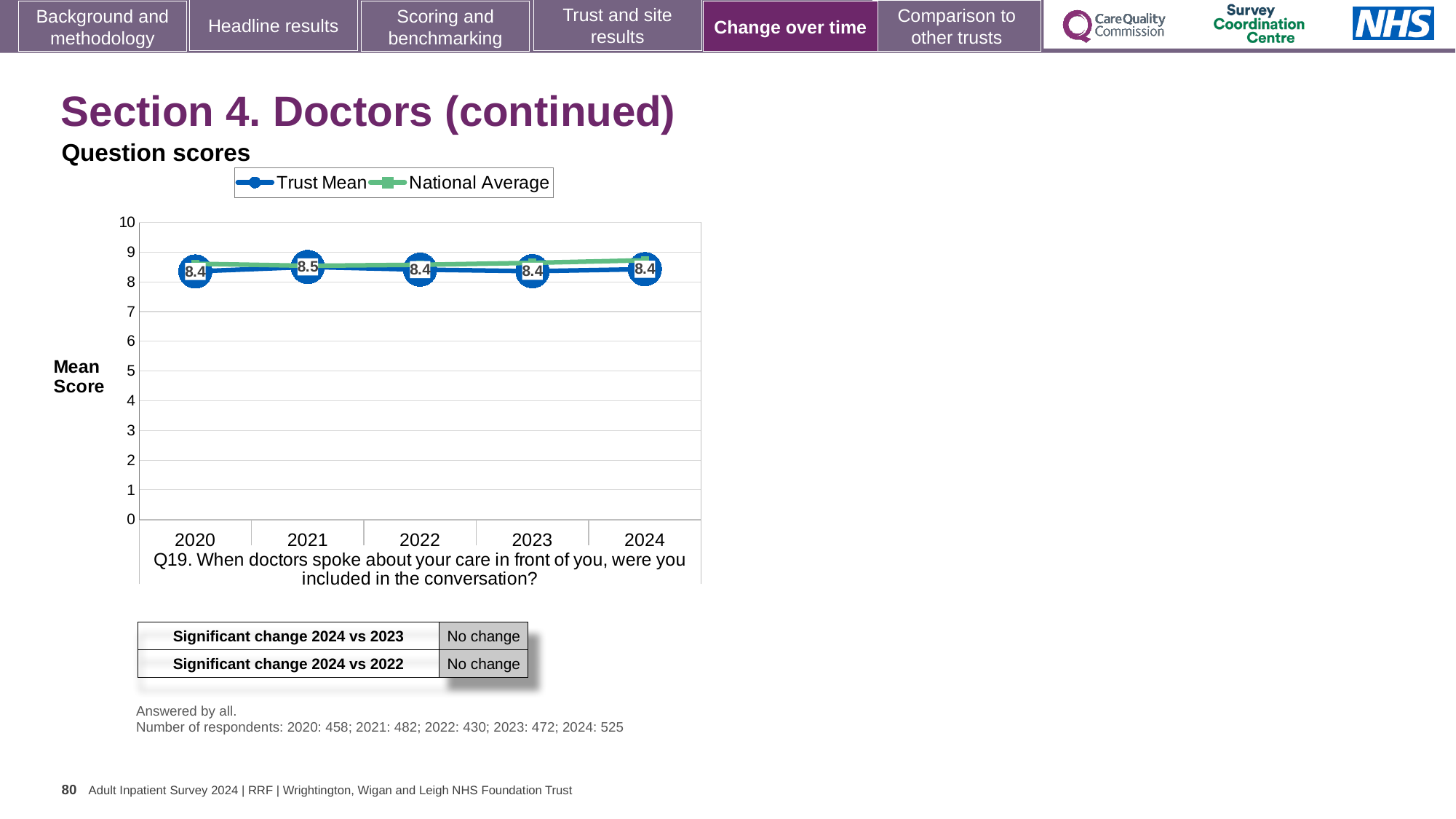
What kind of chart is shown on the slide? Line chart In which year is the Trust Mean score highest? 2021 What is the Trust Mean score for 2024? 8.4 Is the National Average value for 2024 greater or less than 8? greater How many years are plotted on the x axis? 5 What is the difference between the Trust Mean scores for 2021 and 2020? 0.1 What is the Trust Mean score for 2021? 8.5 What are the two series named in the legend? Trust Mean and National Average How many series does the legend list? 2 Which is larger, the Trust Mean score for 2021 or for 2023? 2021 Is the National Average value for 2020 greater or less than 9? less What is the Trust Mean score for 2020? 8.4